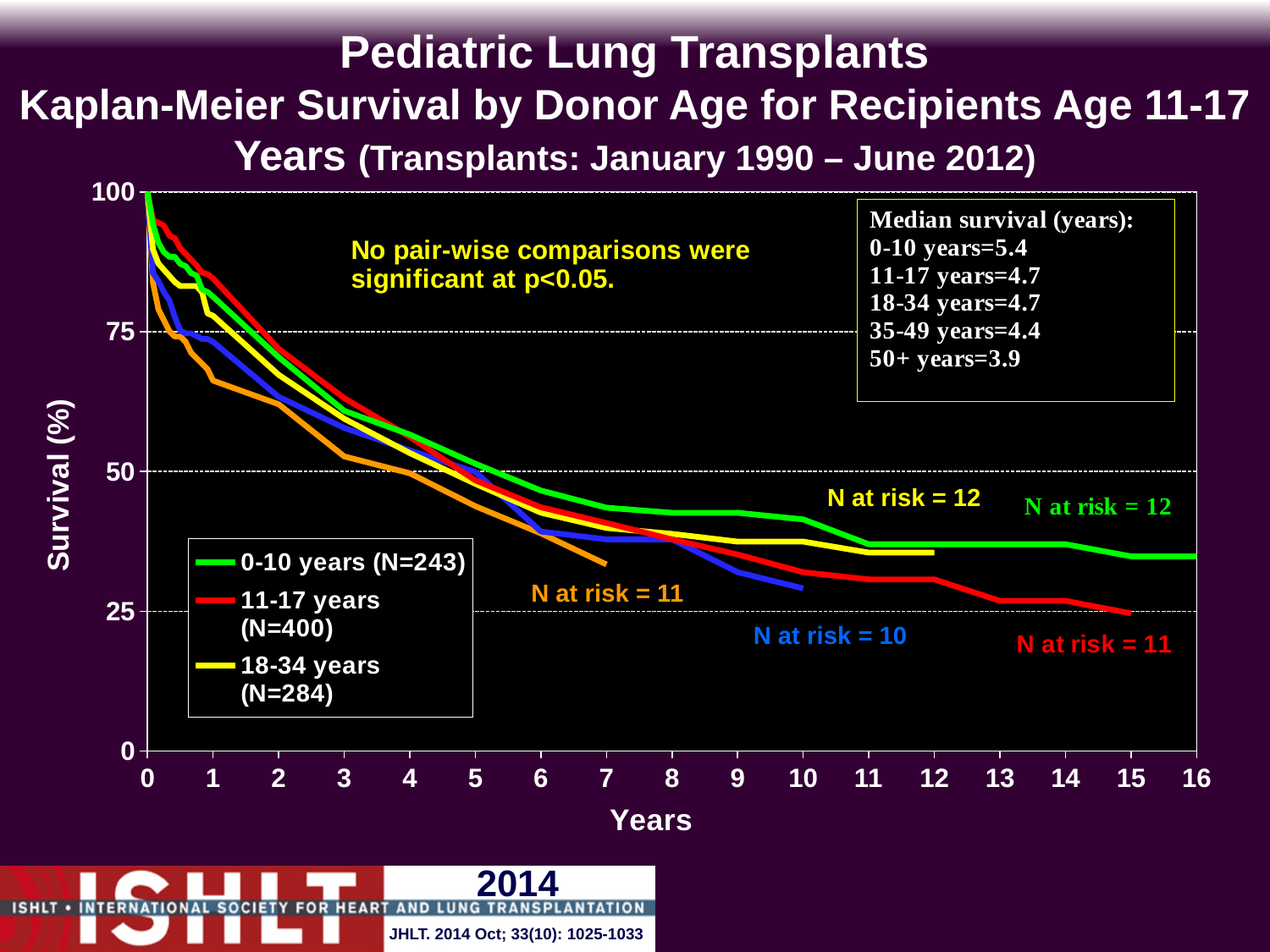
Which donor age group has the lowest median survival? 50+ years What is the difference in median survival between the 0-10 years and 50+ years donor age groups? 1.5 years What is the median survival in years for the 35-49 years donor age group? 4.4 What is the median survival in years for the 50+ years donor age group? 3.9 What is the median survival in years for the 0-10 years donor age group? 5.4 How many series does the legend list? 3 Is the survival for the 0-10 years donor group at 10 years greater or less than 25%? greater What is the N for the 11-17 years donor age group shown in the legend? 400 Do the survival curves rise or fall as years increase? Fall Which donor age group has the highest median survival? 0-10 years What kind of chart is shown on the slide? Line chart Which has a larger median survival, the 0-10 years or the 35-49 years donor age group? 0-10 years